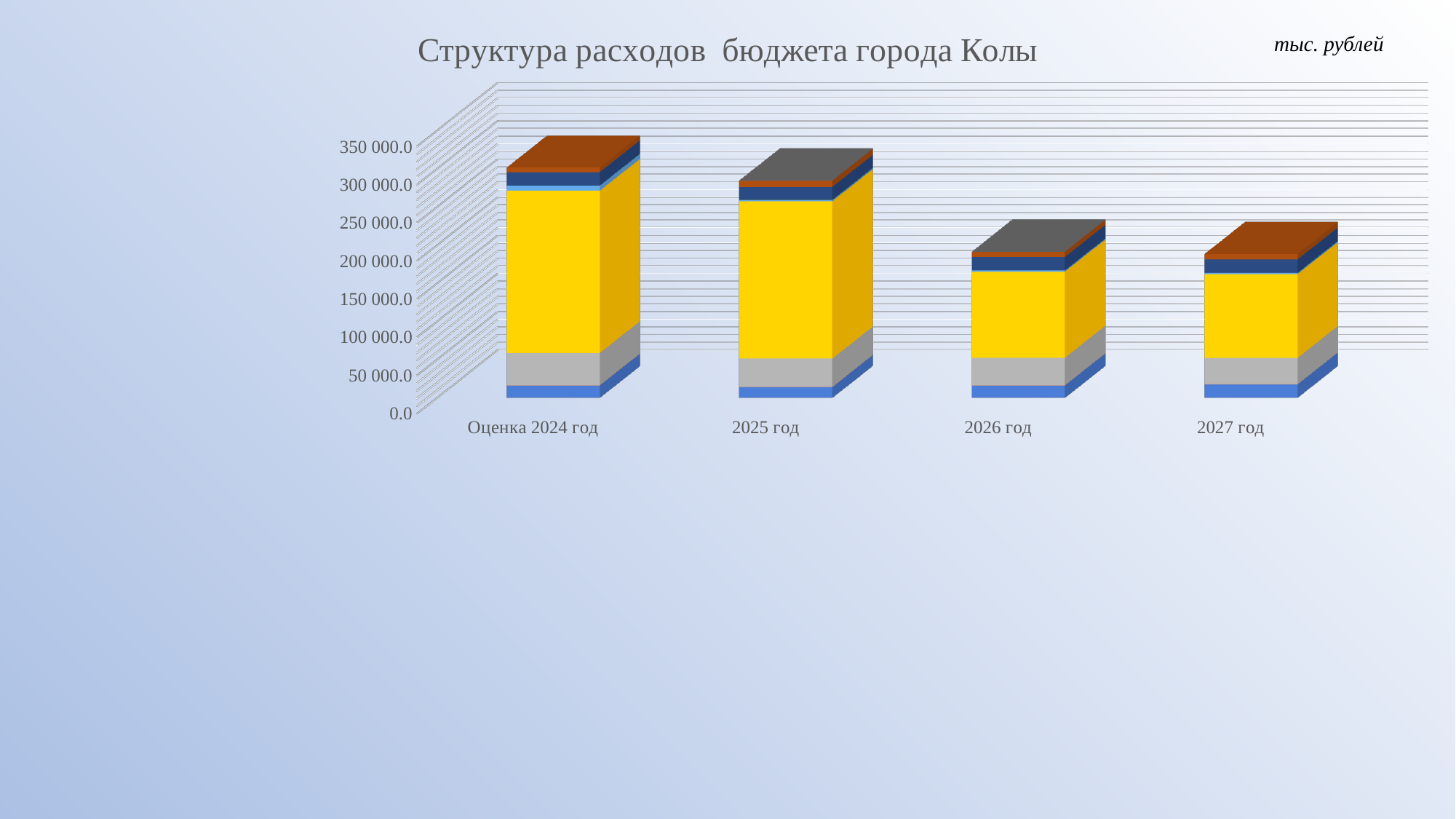
What is the highest value labelled on the vertical axis? 350 000.0 Which stacked bar is taller: Оценка 2024 год or 2026 год? Оценка 2024 год In what units are the values on the chart expressed, according to the note at the top right? тыс. рублей Is the total for 2027 год greater or less than 250 000.0? less What kind of chart is shown on the slide? stacked bar chart Which category has the tallest stacked bar? Оценка 2024 год What is the title of the chart? Структура расходов бюджета города Колы Which stacked bar is taller: 2025 год or 2027 год? 2025 год How many categories (years) are shown on the x axis of the chart? 4 Is the total for 2026 год greater or less than 250 000.0? less Do the total bar heights generally rise or fall from Оценка 2024 год to 2027 год? fall